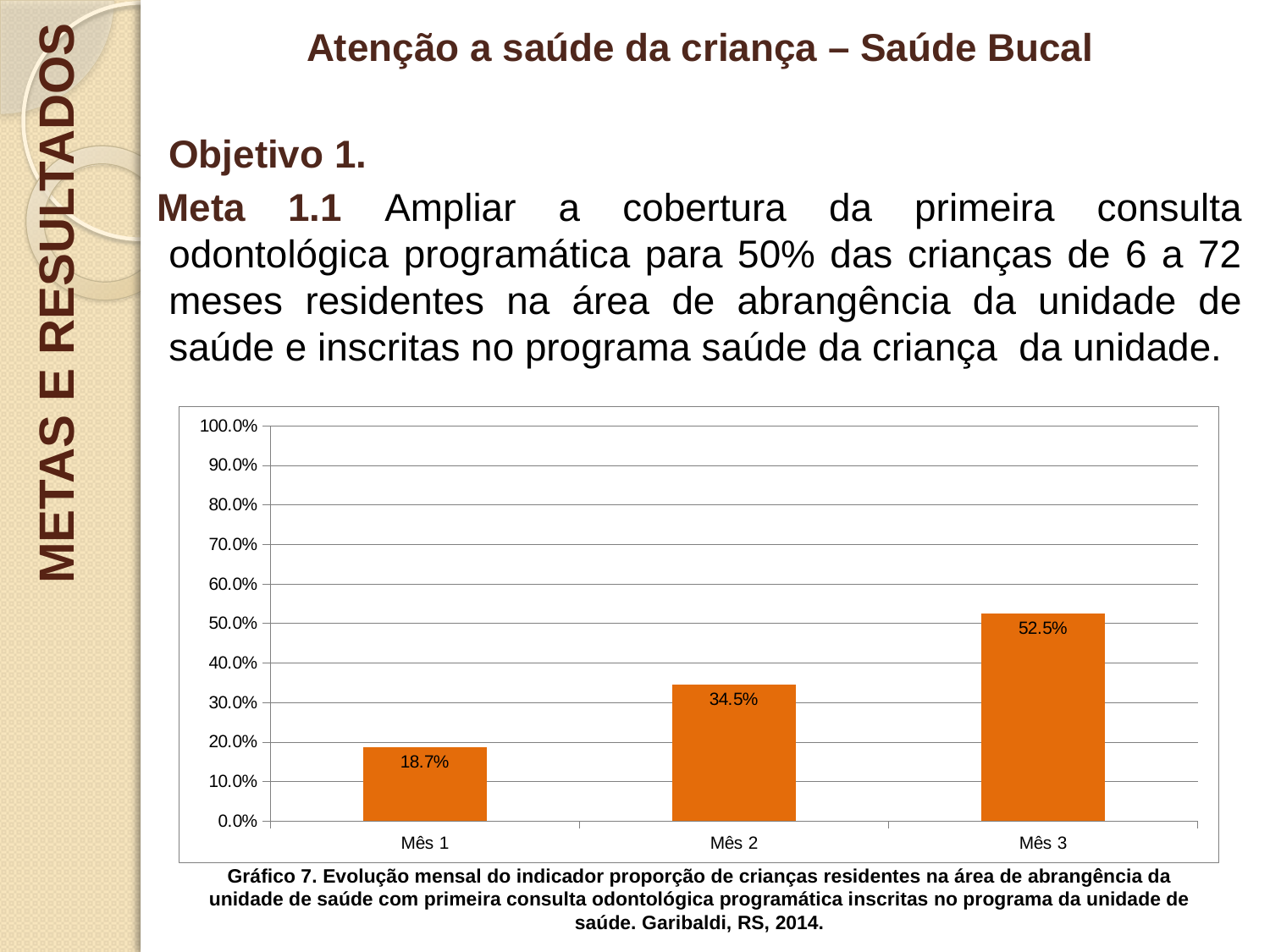
Do the values rise or fall from Mês 1 to Mês 3? rise Which month has the highest value? Mês 3 Which month has the lowest value? Mês 1 What is the value for Mês 2? 34.5% What is the difference between the values for Mês 2 and Mês 1? 15.8% Is the value for Mês 3 greater or less than 50.0%? greater What is the value for Mês 3? 52.5% How many months are shown on the x axis? 3 Which is larger, the value for Mês 2 or the value for Mês 3? Mês 3 What kind of chart is shown on the slide? bar chart What is the value for Mês 1? 18.7% What is the difference between the values for Mês 3 and Mês 1? 33.8%